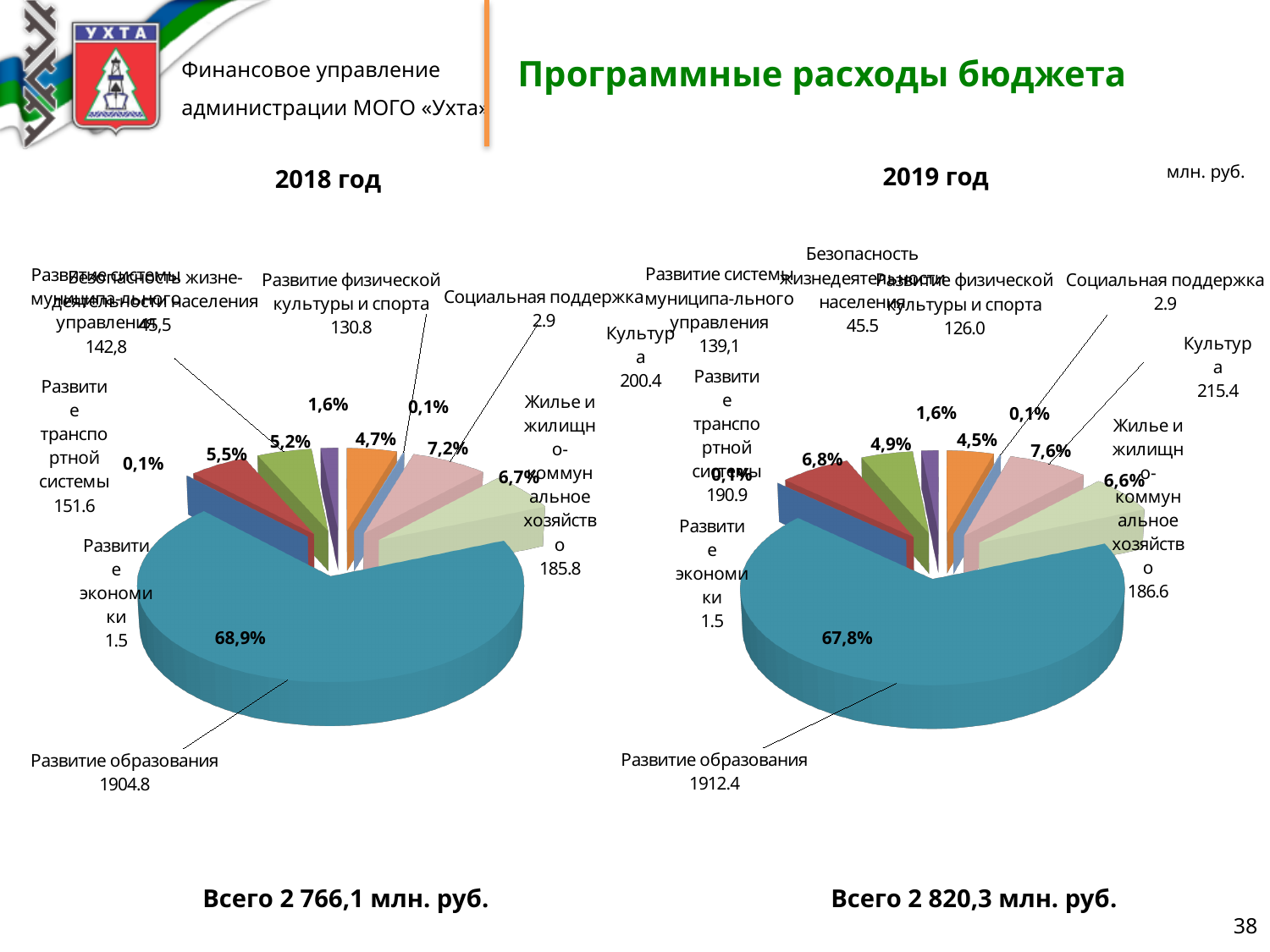
On the 2018 год chart, what is the value for Развитие образования? 1904.8 What is the difference between the Развитие образования values on the 2019 год and 2018 год charts? 7.6 What kind of chart is used for the 2018 год data? Pie chart On the 2018 год chart, which category has the smallest value? Развитие экономики What total is shown below the 2019 год chart? Всего 2 820,3 млн. руб. On the 2019 год chart, which is larger: Культура or Жилье и жилищно-коммунальное хозяйство? Культура On the 2018 год chart, what is the value for Развитие физической культуры и спорта? 130.8 On the 2019 год chart, which category has the largest share? Развитие образования On the 2019 год chart, what is the value for Развитие транспортной системы? 190.9 On the 2019 год chart, what percentage share does Развитие образования have? 67,8% On the 2018 год chart, what percentage share does Развитие образования have? 68,9% On the 2019 год chart, what is the value for Развитие образования? 1912.4